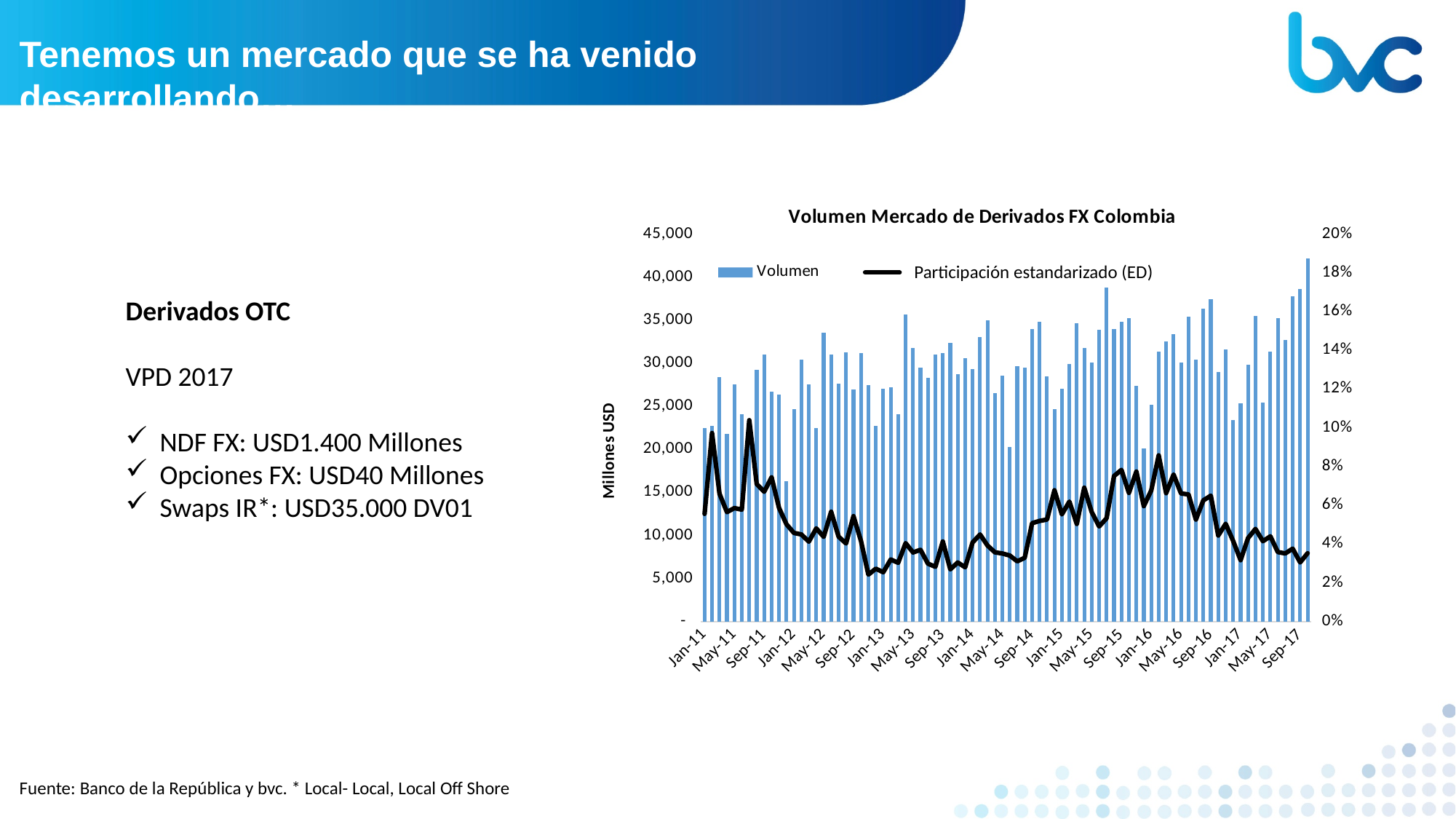
Is the Volumen bar for Jan-11 greater or less than 25,000? less Is the Participación estandarizado (ED) value at Sep-17 greater or less than 6%? less Is the Participación estandarizado (ED) value at its peak around Sep-11 greater or less than 8%? greater What is the title of the chart? Volumen Mercado de Derivados FX Colombia What is the label on the left vertical axis of the chart? Millones USD Which month has the highest Volumen bar in the chart? Oct-17 Does the Participación estandarizado (ED) line generally rise or fall from Jan-16 to Sep-17? fall Which series is drawn as a black line in the chart? Participación estandarizado (ED) How many series does the chart's legend list? 2 What kind of chart is shown on the slide? A combined bar and line chart